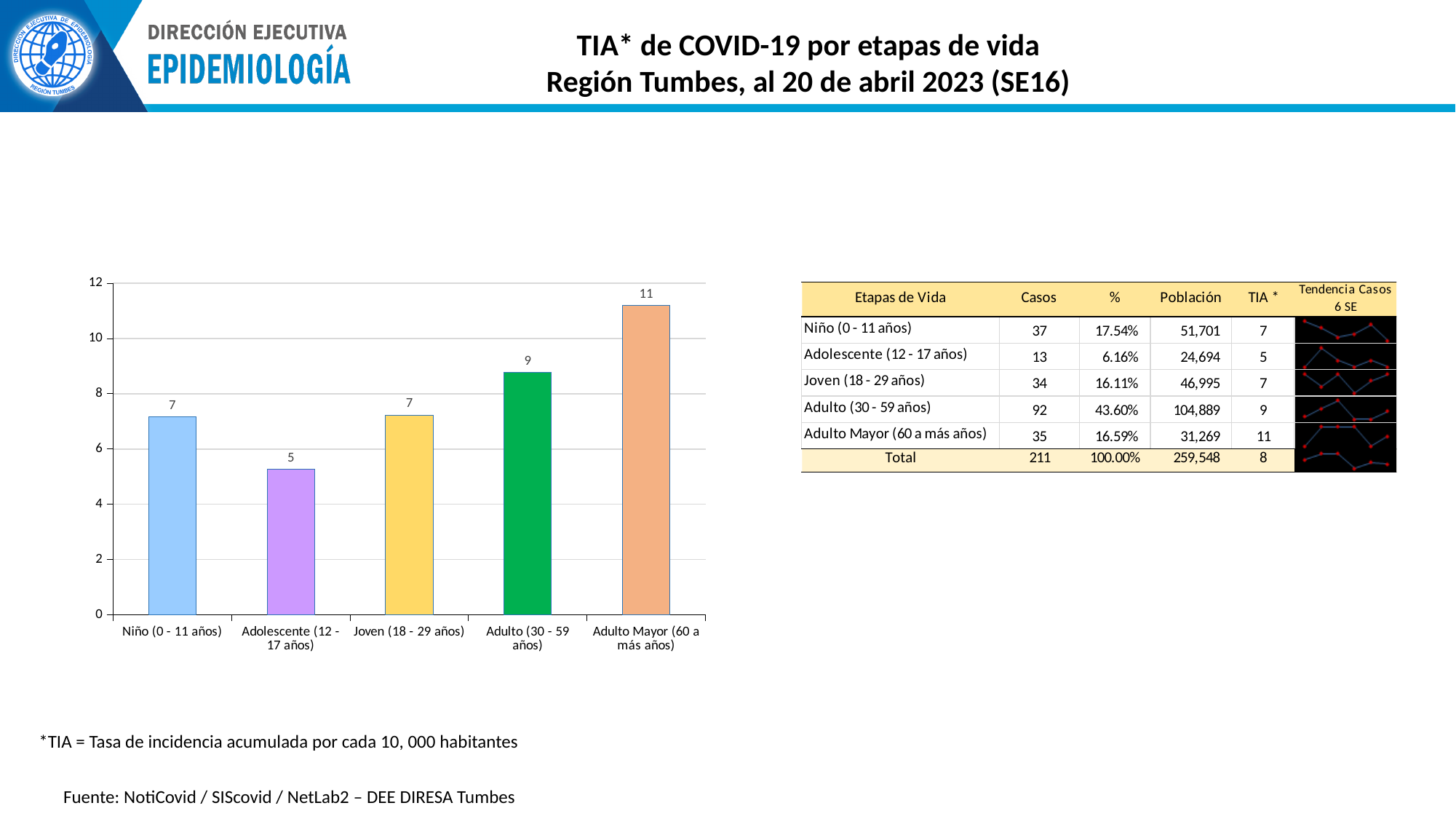
What kind of chart is shown on the slide? bar chart What is the TIA value shown for Adulto (30 - 59 años) in the bar chart? 9 What colour is the bar for Adulto (30 - 59 años)? green What is the difference between the labelled values for Adulto Mayor (60 a más años) and Adolescente (12 - 17 años)? 6 Which has a larger value in the bar chart, Adulto (30 - 59 años) or Joven (18 - 29 años)? Adulto (30 - 59 años) What is the maximum value shown on the vertical axis of the bar chart? 12 Which life stage has the lowest bar in the chart? Adolescente (12 - 17 años) What is the TIA value shown for Adulto Mayor (60 a más años) in the bar chart? 11 What is the TIA value shown for Adolescente (12 - 17 años) in the bar chart? 5 Is the value for Adulto Mayor (60 a más años) greater or less than 10? greater How many life-stage categories are plotted in the bar chart? 5 Which life stage has the highest bar in the chart? Adulto Mayor (60 a más años)